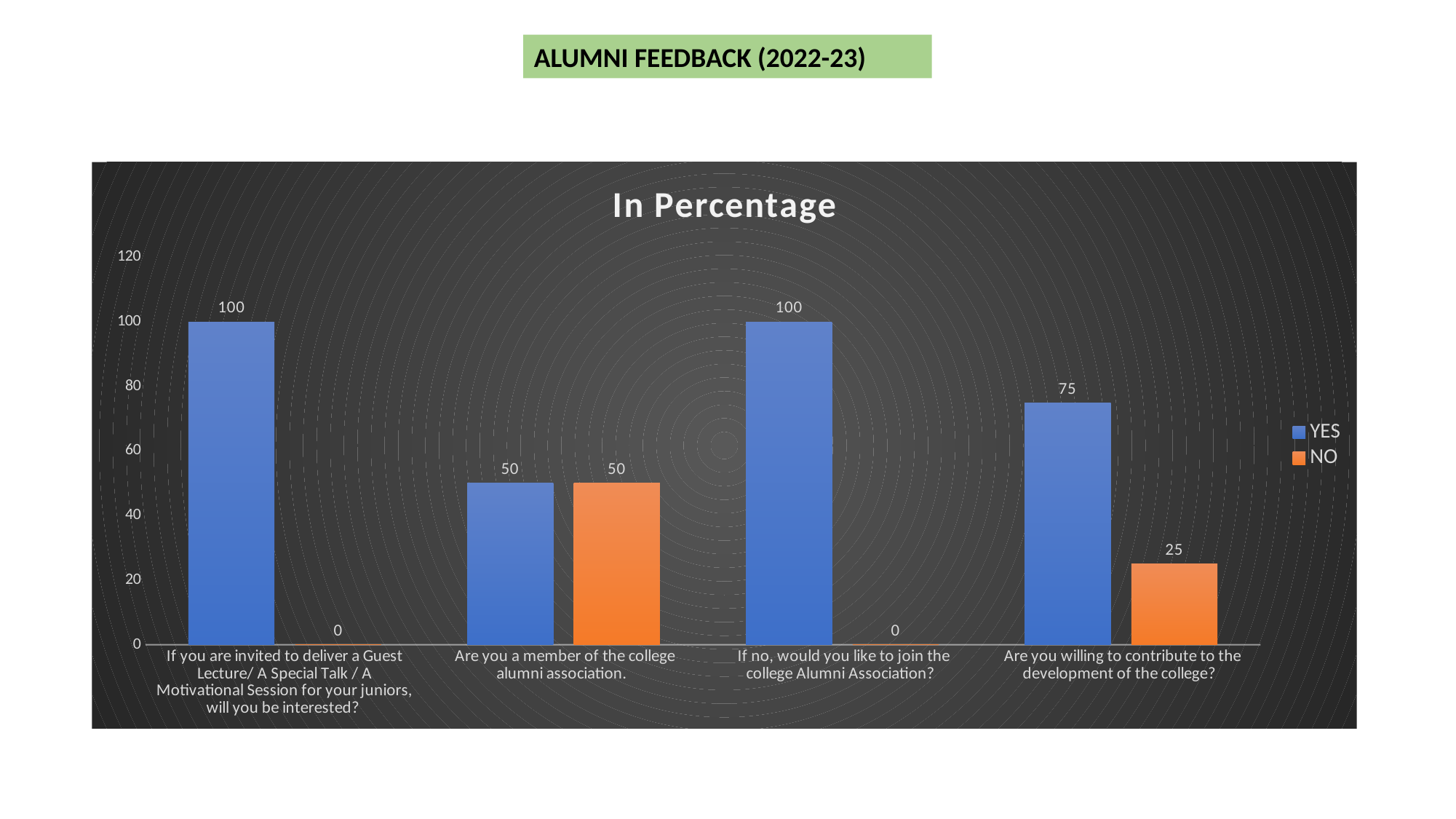
What is the NO value for "If no, would you like to join the college Alumni Association?"? 0 What is the YES value for "Are you willing to contribute to the development of the college?"? 75 Which question has the highest NO value? Are you a member of the college alumni association. What kind of chart is shown on the slide? Bar chart What is the difference between the YES and NO values for "Are you willing to contribute to the development of the college?"? 50 How many questions (categories) are shown on the x axis? 4 What is the title of the chart? In Percentage What is the NO value for "Are you willing to contribute to the development of the college?"? 25 How many series does the legend list? 2 Which is larger for "Are you willing to contribute to the development of the college?": the YES value or the NO value? YES What is the NO value for "Are you a member of the college alumni association."? 50 Which question has the lowest YES value? Are you a member of the college alumni association.